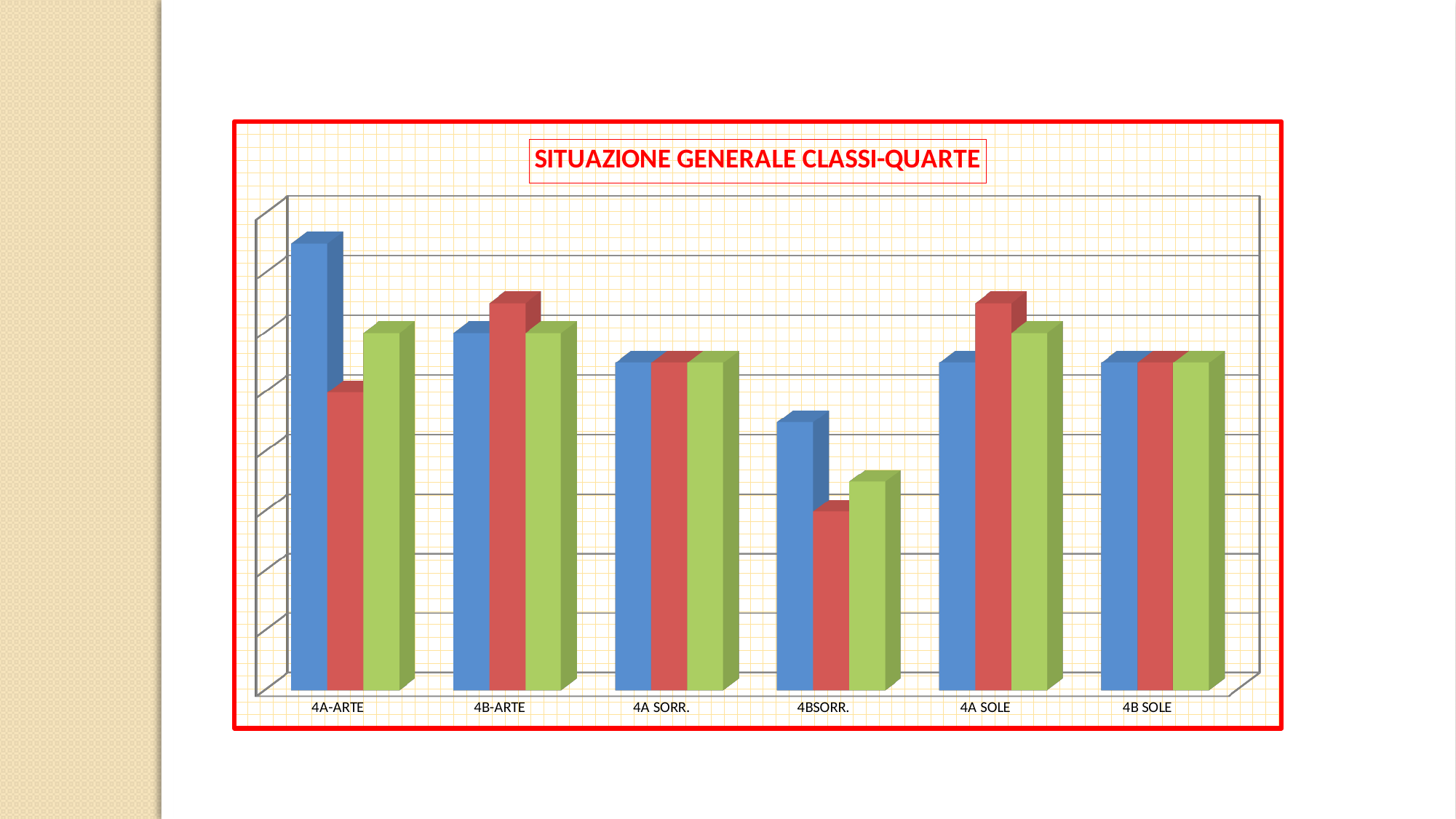
Which category has the shortest red bar? 4BSORR. How many bars are plotted for each category in the chart? 3 Which category has the tallest blue bar? 4A-ARTE For 4A SOLE, which is taller, the red bar or the green bar? the red bar For 4B-ARTE, which is taller, the red bar or the blue bar? the red bar For 4A-ARTE, which is taller, the blue bar or the red bar? the blue bar How many categories are shown on the x axis of the chart? 6 Which category has the shortest green bar? 4BSORR. What kind of chart is shown on the slide? bar chart Which category has the shortest blue bar? 4BSORR. What is the title of the chart? SITUAZIONE GENERALE CLASSI-QUARTE What colours are the three bars in each category of the chart? blue, red and green